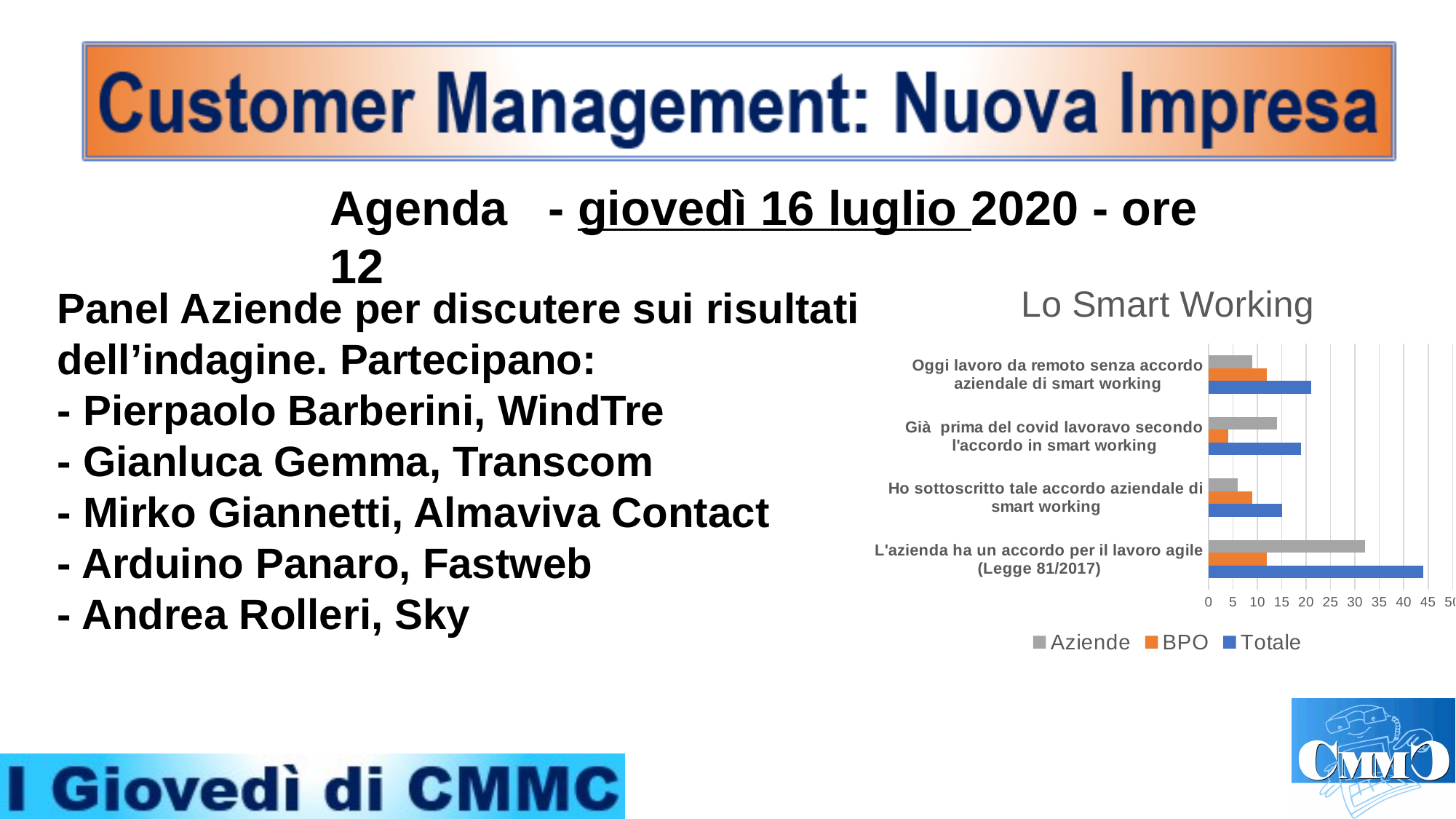
For "Oggi lavoro da remoto senza accordo aziendale di smart working", which is larger: the Totale value or the Aziende value? Totale Is the Totale value for "L'azienda ha un accordo per il lavoro agile (Legge 81/2017)" greater or less than 40? greater For "Già prima del covid lavoravo secondo l'accordo in smart working", which is larger: the Aziende value or the BPO value? Aziende Which category has the highest Totale value in the "Lo Smart Working" chart? L'azienda ha un accordo per il lavoro agile (Legge 81/2017) Is the Aziende value for "L'azienda ha un accordo per il lavoro agile (Legge 81/2017)" greater or less than 30? greater What colour represents the Totale series in the "Lo Smart Working" chart? blue How many series does the legend of the "Lo Smart Working" chart list? 3 Which category has the lowest BPO value in the "Lo Smart Working" chart? Già prima del covid lavoravo secondo l'accordo in smart working How many categories are plotted in the "Lo Smart Working" chart? 4 Which category has the lowest Totale value in the "Lo Smart Working" chart? Ho sottoscritto tale accordo aziendale di smart working What kind of chart is shown under the title "Lo Smart Working"? bar chart